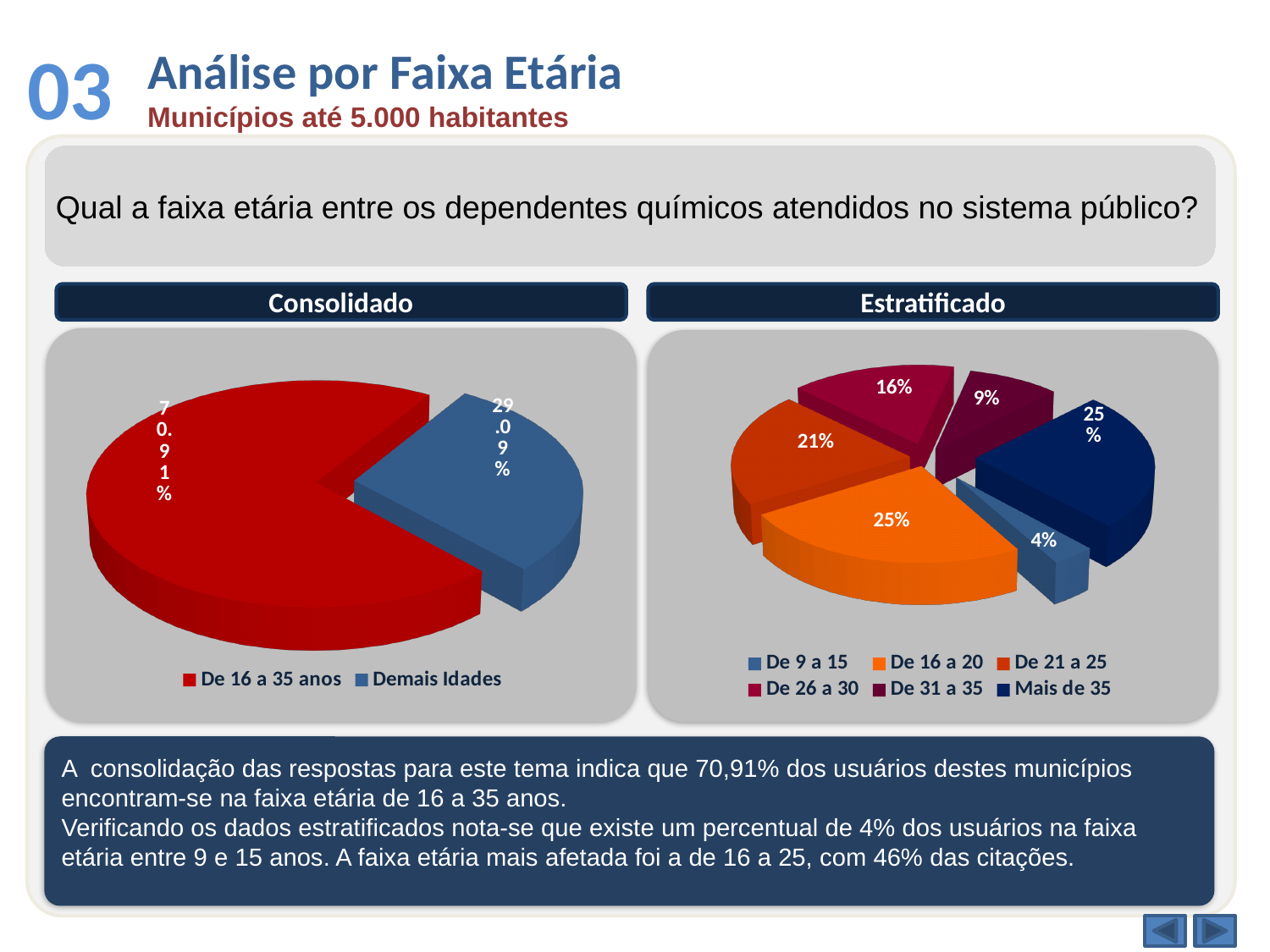
What kind of chart is the Consolidado chart? Pie chart In the Consolidado chart, what is the value for De 16 a 35 anos? 70.91% In the Estratificado chart, what is the value for De 21 a 25? 21% In the Estratificado chart, what is the value for De 9 a 15? 4% How many categories does the legend of the Estratificado chart list? 6 In the Estratificado chart, what is the value for De 26 a 30? 16% In the Consolidado chart, which slice is larger, De 16 a 35 anos or Demais Idades? De 16 a 35 anos In the Estratificado chart, what is the value for De 31 a 35? 9% In the Estratificado chart, what is the difference between De 16 a 20 and De 21 a 25? 4% In the Estratificado chart, which category has the smallest share? De 9 a 15 In the Consolidado chart, what is the value for Demais Idades? 29.09% In the Estratificado chart, which is larger, De 26 a 30 or De 31 a 35? De 26 a 30